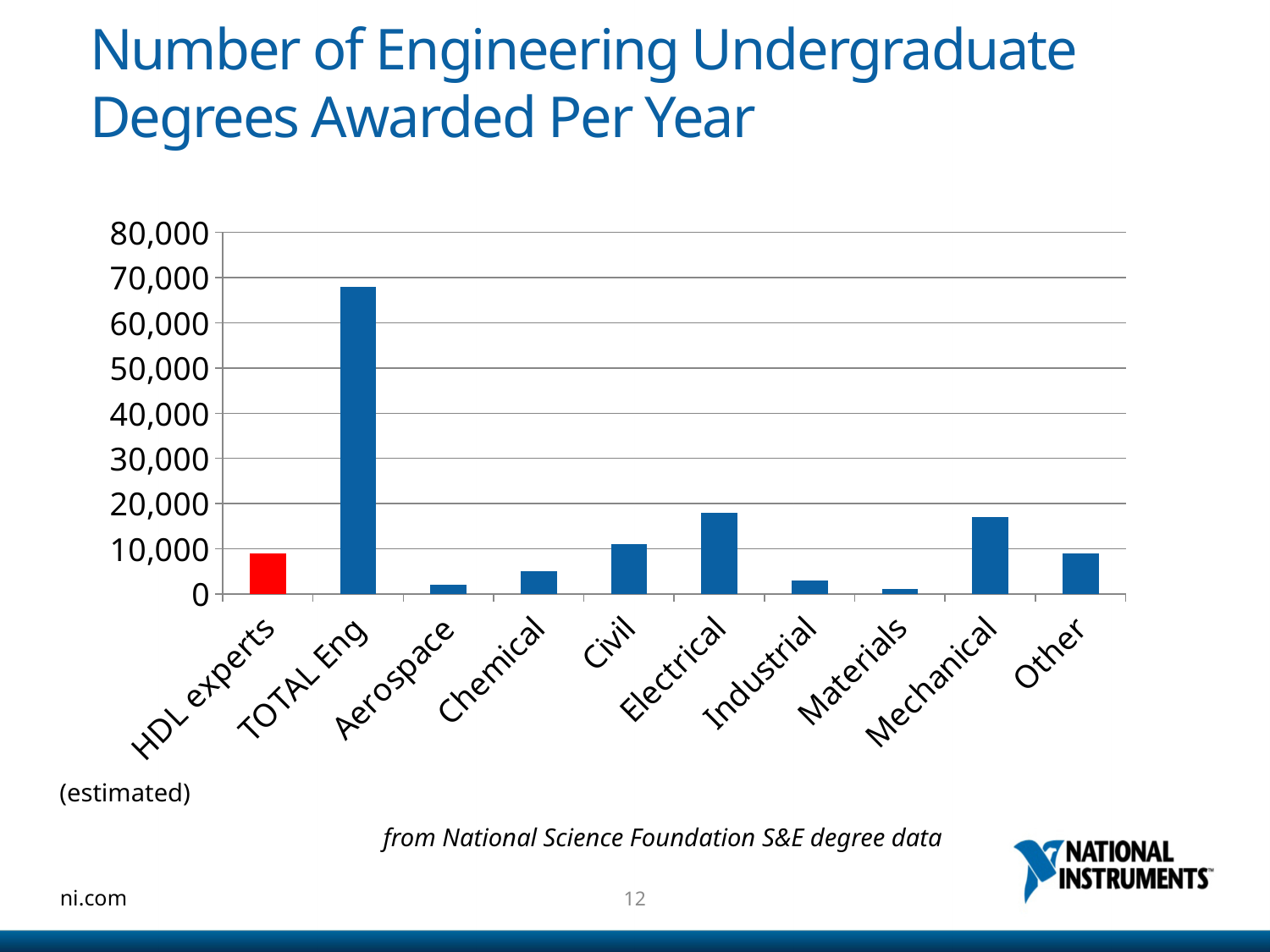
Which is larger, the value for Civil or the value for Chemical? Civil How many categories are shown on the x axis of the chart? 10 Is the value for Chemical greater or less than 10,000? less Which category's bar is coloured red in the chart? HDL experts Which category has the lowest value in the chart? Materials Is the value for Electrical greater or less than 10,000? greater Which is larger, the value for Electrical or the value for Industrial? Electrical Is the value for Aerospace greater or less than 10,000? less Which category has the highest value in the chart? TOTAL Eng What kind of chart is shown on the slide? bar chart